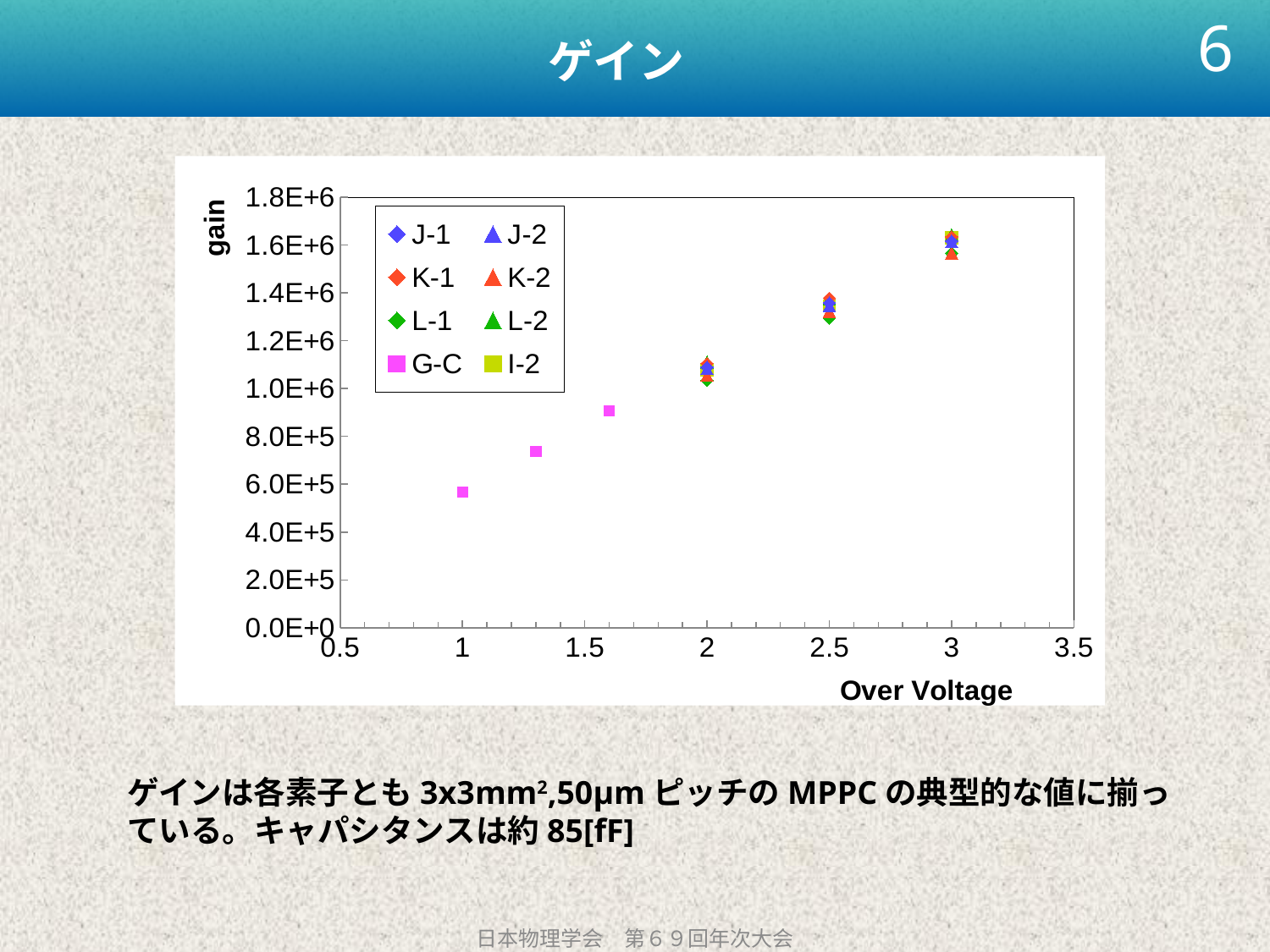
What kind of chart is shown on the slide? scatter chart How many data points are plotted for the G-C series? 3 Do the gain values rise or fall as Over Voltage increases? rise Is the gain of G-C at Over Voltage 1 greater or less than 4.0E+5? greater Is the gain of G-C at Over Voltage 1.6 greater or less than 8.0E+5? greater Which is larger: the gain of G-C at Over Voltage 1.6 or at Over Voltage 1? Over Voltage 1.6 Is the gain of J-1 at Over Voltage 2.5 greater or less than 1.2E+6? greater What is the label of the y axis of the chart? gain What is the label of the x axis of the chart? Over Voltage How many series does the chart legend list? 8